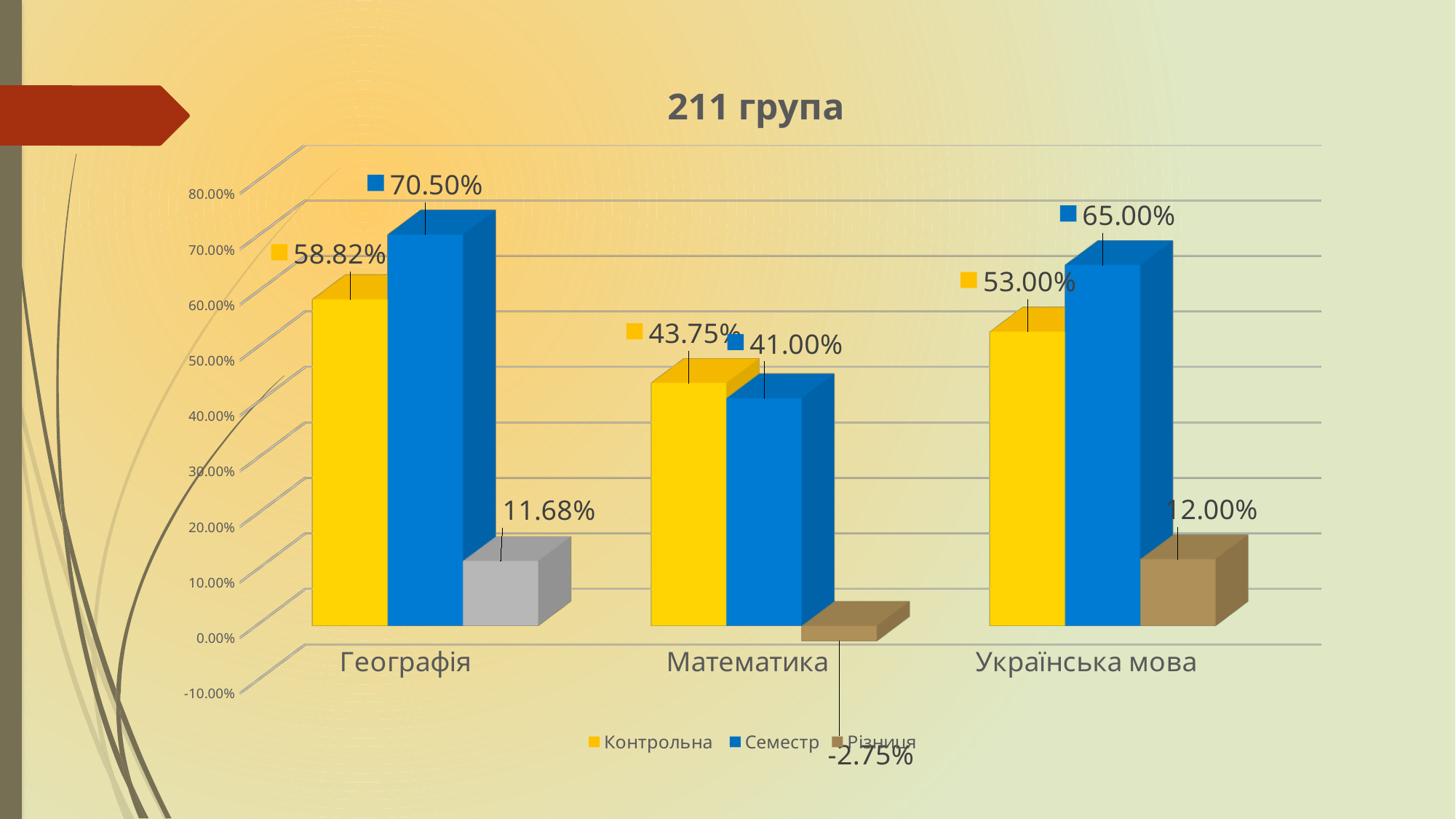
What is the Різниця value for Українська мова? 12.00% How many series does the legend list? 3 What is the title of the chart? 211 група What is the Різниця value for Математика? -2.75% Which category has the lowest Контрольна value? Математика How many categories are shown on the x axis? 3 What type of chart is shown on the slide? bar chart Which category has the highest Семестр value? Географія What is the Контрольна value for Математика? 43.75% What is the difference between the Семестр and Контрольна values for Українська мова? 12.00% Which is larger for Математика, the Контрольна value or the Семестр value? Контрольна What is the Семестр value for Географія? 70.50%